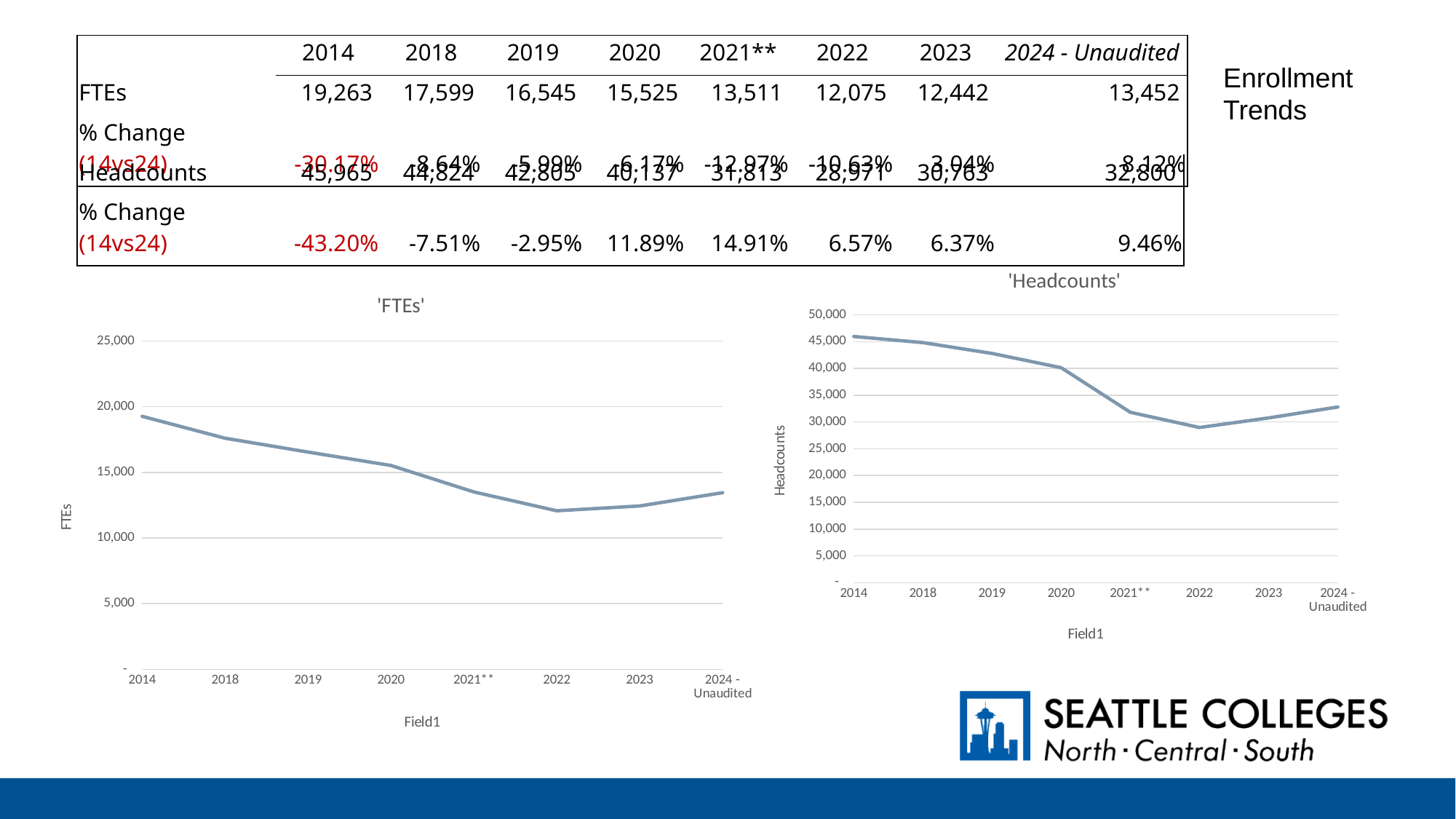
In the 'Headcounts' chart, is the value for 2022 greater or less than 35,000? less In the 'Headcounts' chart, which year has the lowest value? 2022 What kind of chart is the 'FTEs' chart? line chart In the 'Headcounts' chart, is the value for 2018 greater or less than 40,000? greater In the 'FTEs' chart, is the value for 2022 greater or less than 15,000? less In the 'FTEs' chart, do the values generally rise or fall from 2014 to 2022? fall In the 'Headcounts' chart, which is larger, the value for 2018 or the value for 2023? 2018 In the 'Headcounts' chart, which year has the highest value? 2014 In the 'FTEs' chart, which year has the highest value? 2014 In the 'FTEs' chart, which year has the lowest value? 2022 How many years are plotted on the x axis of the 'FTEs' chart? 8